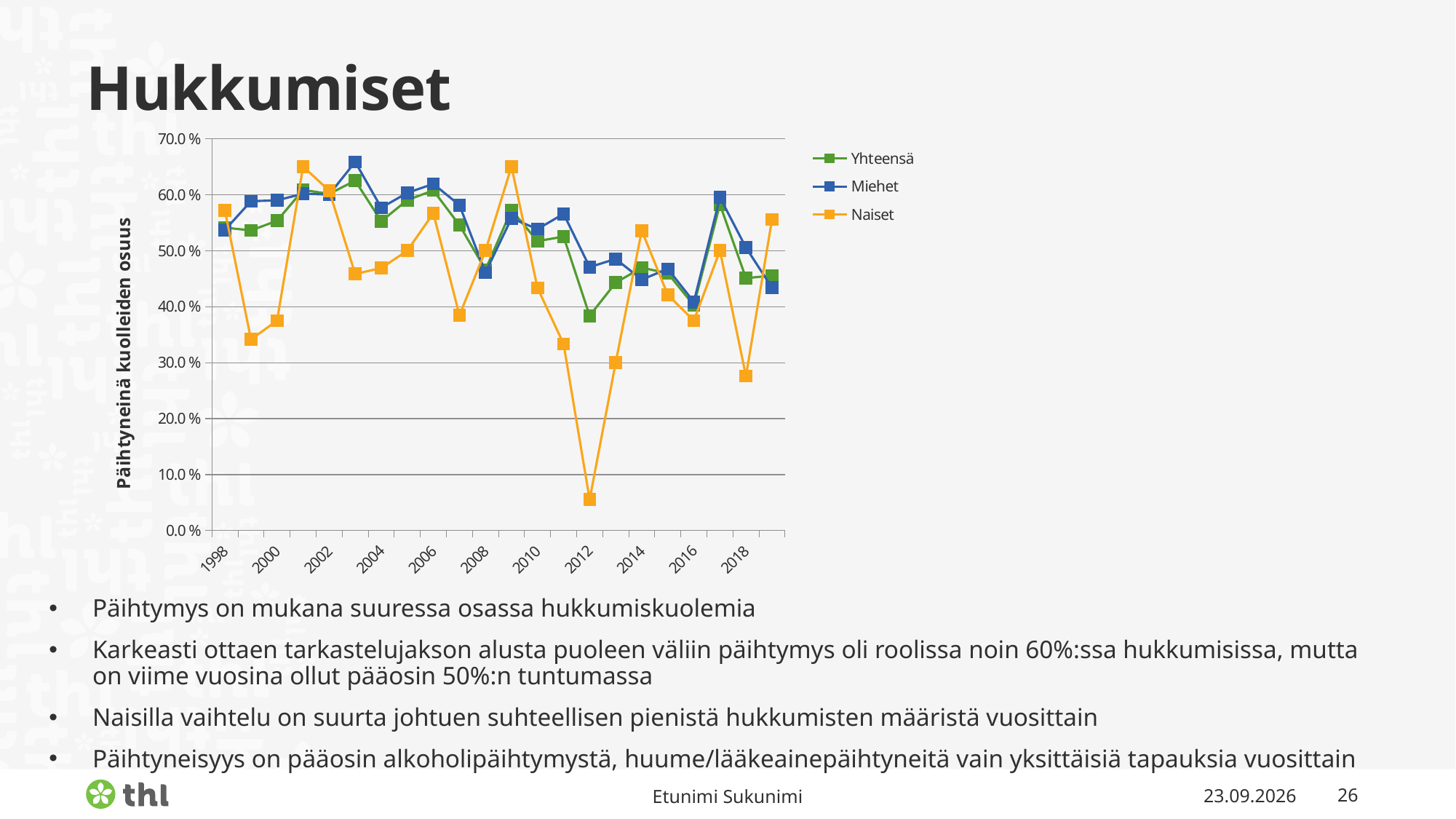
Does the Naiset series rise or fall between 2009 and 2012? fall In which year does the Naiset series reach its lowest value? 2012 How many series does the legend list? 3 Is the value for Naiset in 2012 greater or less than 10.0 %? less Which series are listed in the legend? Yhteensä, Miehet, Naiset What is the title of the vertical axis? Päihtyneinä kuolleiden osuus What kind of chart is shown on the slide? line chart In 2012, which series has the larger value, Miehet or Naiset? Miehet How many year labels are shown on the x axis? 11 Is the value for Miehet in 2003 greater or less than 60.0 %? greater In which year does the Miehet series reach its highest value? 2003 Is the value for Naiset in 2018 greater or less than 30.0 %? less